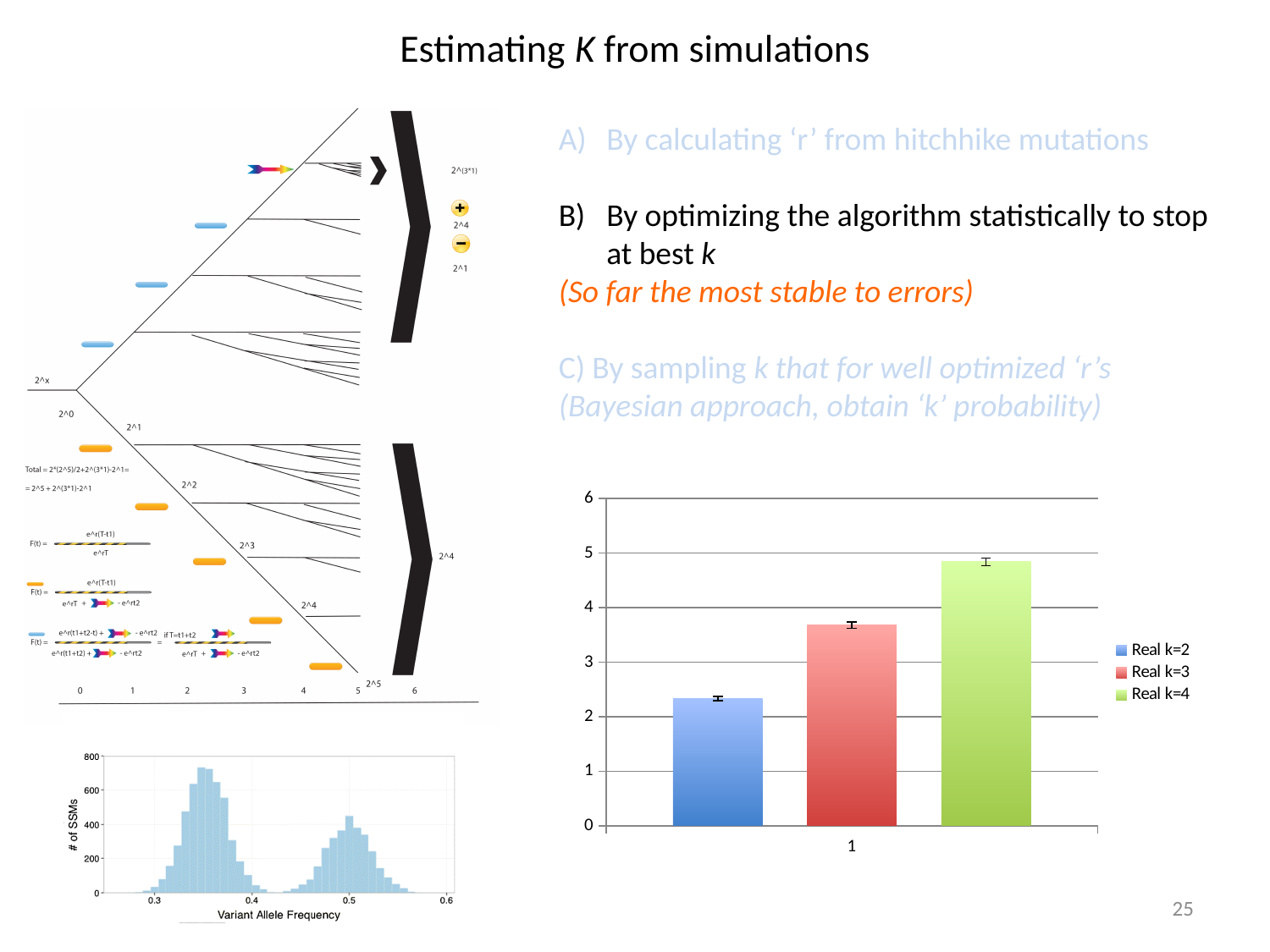
In the histogram at the bottom left, what is the label of the horizontal axis? Variant Allele Frequency In the bar chart on the right, is the value for Real k=3 greater or less than 3? greater In the bar chart on the right, which series has the shortest bar? Real k=2 In the bar chart on the right, how many series does the legend list? 3 In the bar chart on the right, is the value for Real k=2 greater or less than 3? less What kind of chart is shown on the right side of the slide? bar chart In the bar chart on the right, what is the highest value shown on the vertical axis? 6 In the bar chart on the right, what colour is the bar for Real k=3? red In the bar chart on the right, which series has the tallest bar? Real k=4 In the bar chart on the right, which is larger, the bar for Real k=2 or the bar for Real k=3? Real k=3 In the bar chart on the right, is the value for Real k=4 greater or less than 4? greater